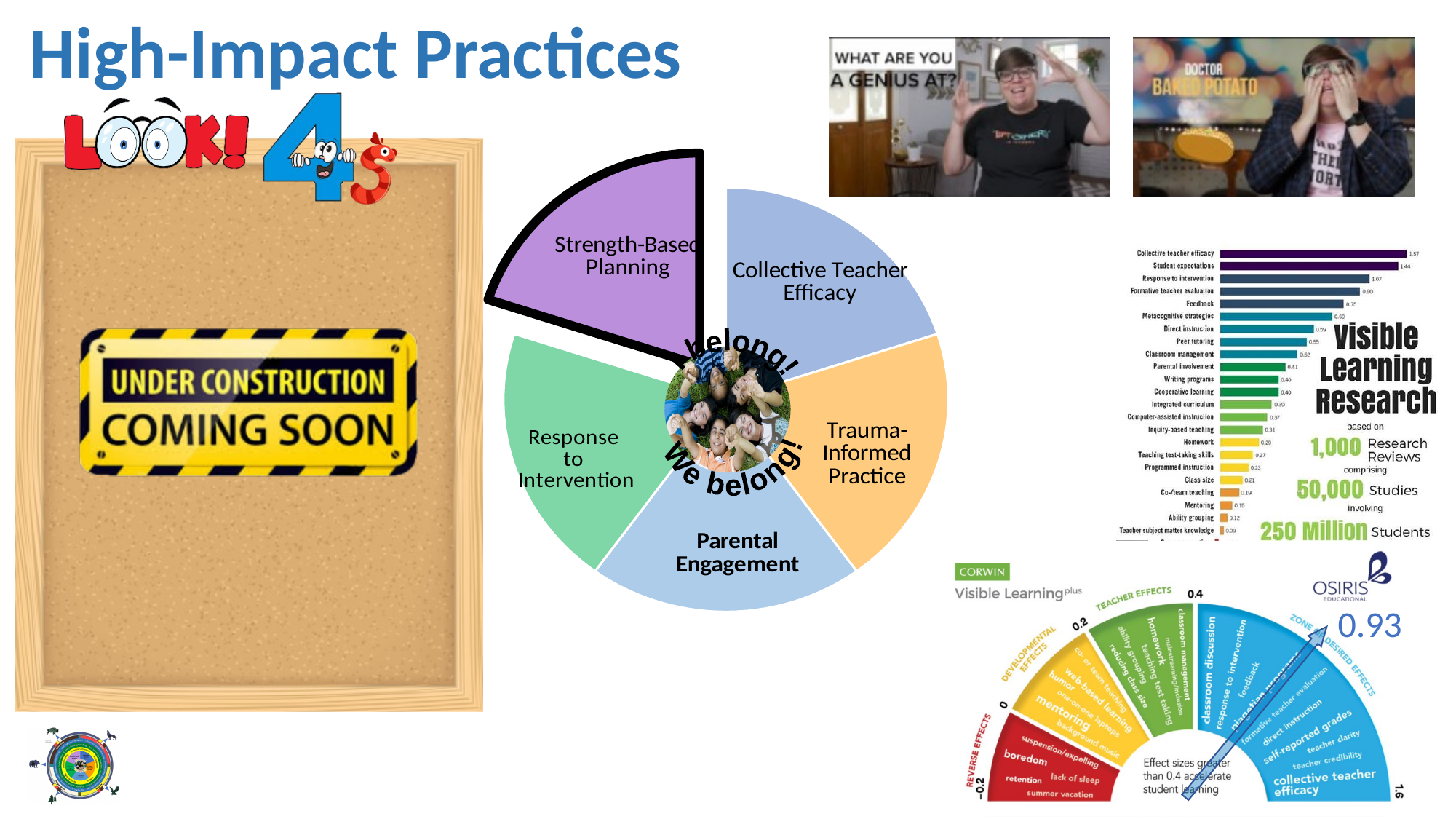
In the Visible Learning Research bar chart, which is larger: Feedback or Homework? Feedback In the centre pie chart, which segment is coloured orange? Trauma-Informed Practice In the centre pie chart, which segment is outlined in black and pulled away from the rest? Strength-Based Planning What kind of chart is the Visible Learning Research chart on the right of the slide? Bar chart What kind of chart is the chart in the centre of the slide with the segments Strength-Based Planning and Collective Teacher Efficacy? Pie chart In the Visible Learning Research bar chart, what is the difference between Collective teacher efficacy and Student expectations? 0.13 In the Visible Learning Research bar chart, what is the value for Student expectations? 1.44 In the Visible Learning Research bar chart, which category has the highest effect size? Collective teacher efficacy How many segments does the centre pie chart have? 5 In the Visible Learning Research bar chart, what is the value for Collective teacher efficacy? 1.57 In the Visible Learning Research bar chart, do the values rise or fall going down the list of categories? Fall In the Visible Learning Research bar chart, what is the value for Response to intervention? 1.07